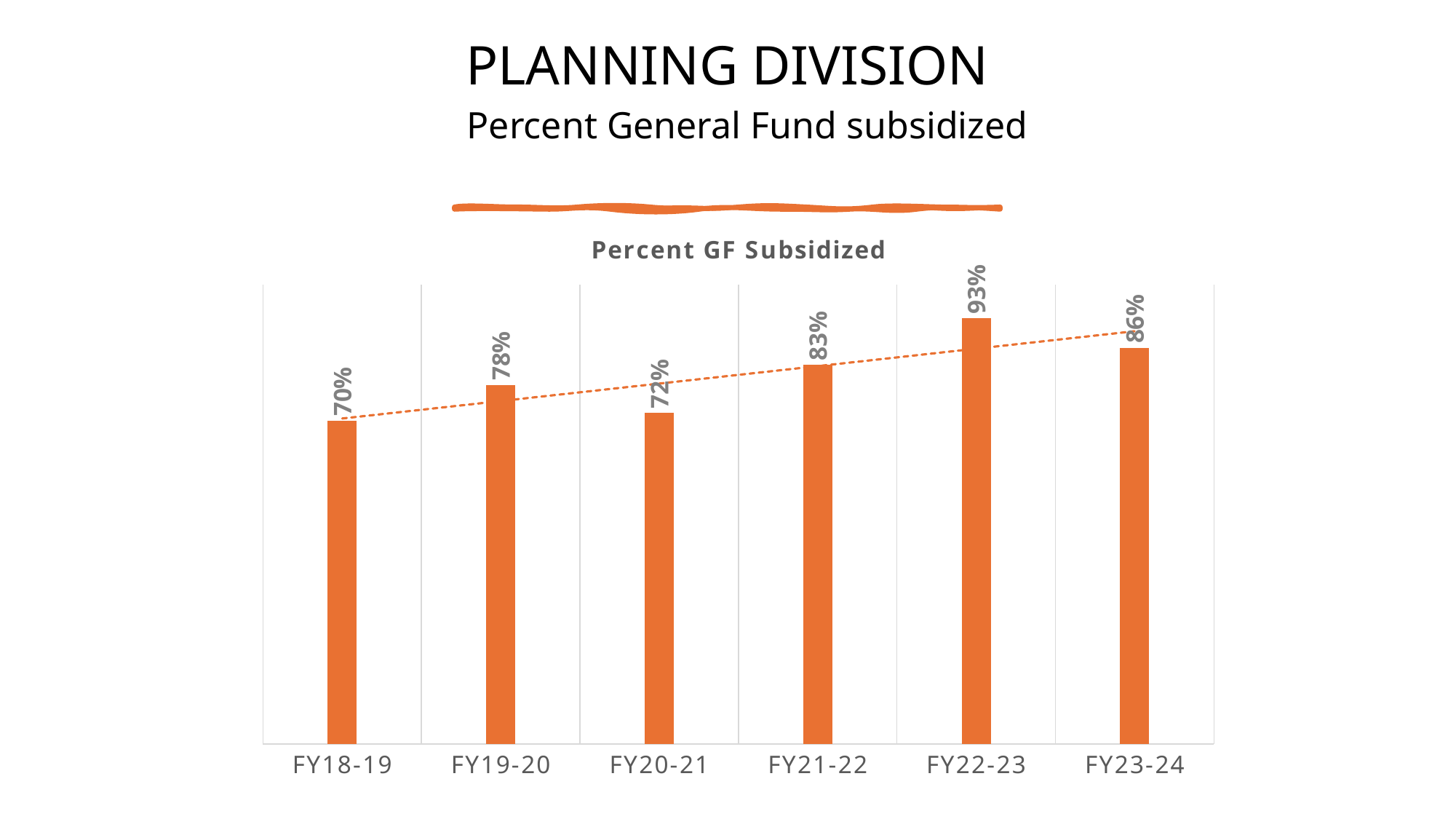
What is the difference between the Percent GF Subsidized for FY19-20 and FY20-21? 6% Which fiscal year has the lowest Percent GF Subsidized? FY18-19 What is the title of the chart on the slide? Percent GF Subsidized Which is larger, the Percent GF Subsidized for FY19-20 or FY20-21? FY19-20 What kind of chart is used to show Percent GF Subsidized? Bar chart What is the difference between the Percent GF Subsidized for FY22-23 and FY18-19? 23% What is the Percent GF Subsidized value for FY21-22? 83% What is the Percent GF Subsidized value for FY23-24? 86% Which is larger, the Percent GF Subsidized for FY22-23 or FY23-24? FY22-23 How many fiscal years are shown in the Percent GF Subsidized chart? 6 Which fiscal year has the highest Percent GF Subsidized? FY22-23 What is the Percent GF Subsidized value for FY18-19? 70%